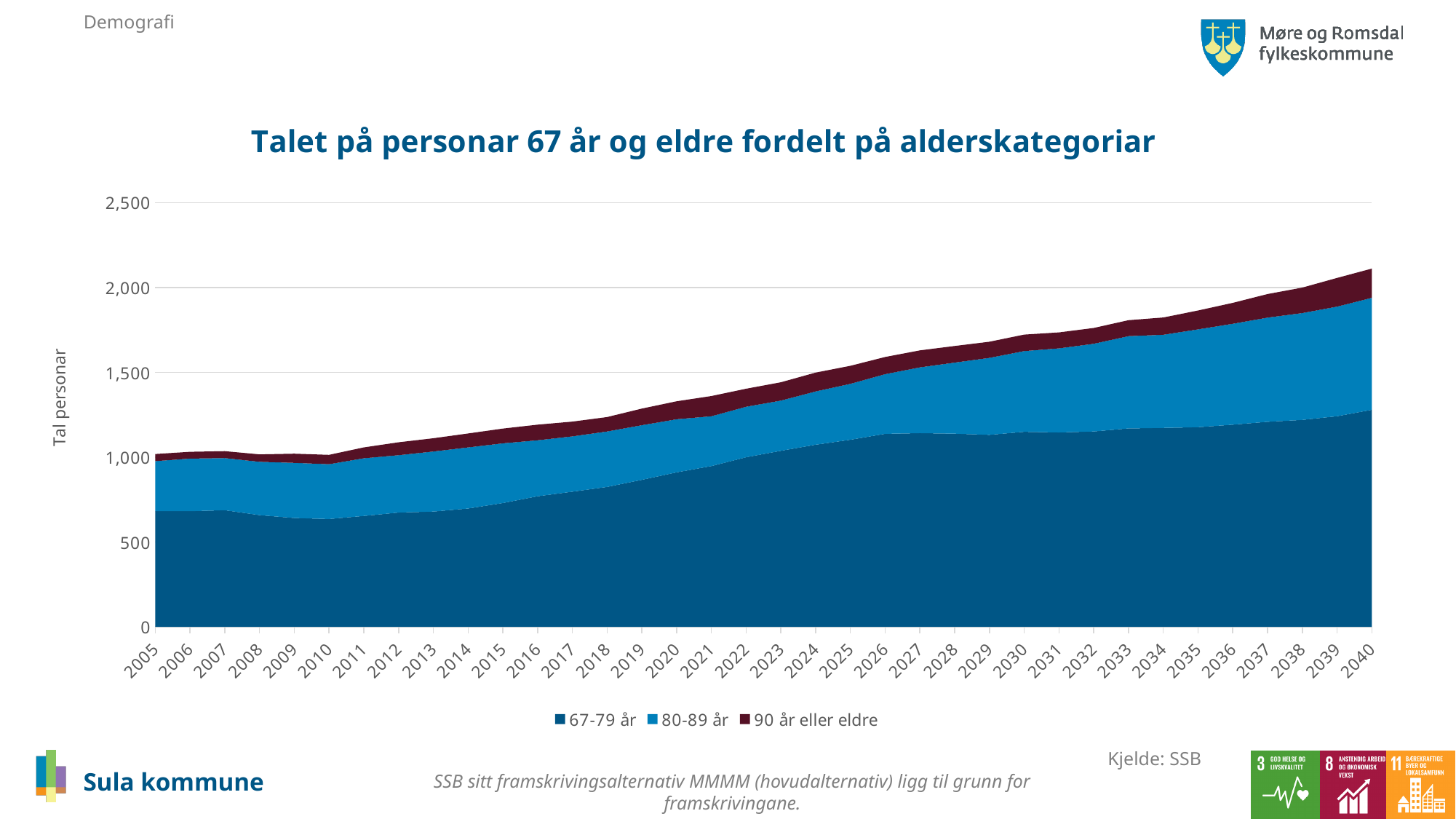
In which year is the total number of persons 67 years and older highest? 2040 What is the title of the chart? Talet på personar 67 år og eldre fordelt på alderskategoriar How many series does the legend list? 3 Is the total value for 2020 greater or less than 1,500? less Which is larger, the total for 2005 or the total for 2040? 2040 Does the total number of persons 67 years and older rise or fall from 2005 to 2040? Rise How many years are shown along the x axis? 36 Which age category has the largest value in 2040? 67-79 år Is the total value for 2040 greater or less than 2,000? greater What are the three series listed in the legend? 67-79 år, 80-89 år, 90 år eller eldre Is the value for the 67-79 år series in 2040 greater or less than 1,000? greater What kind of chart is shown on the slide? Stacked area chart